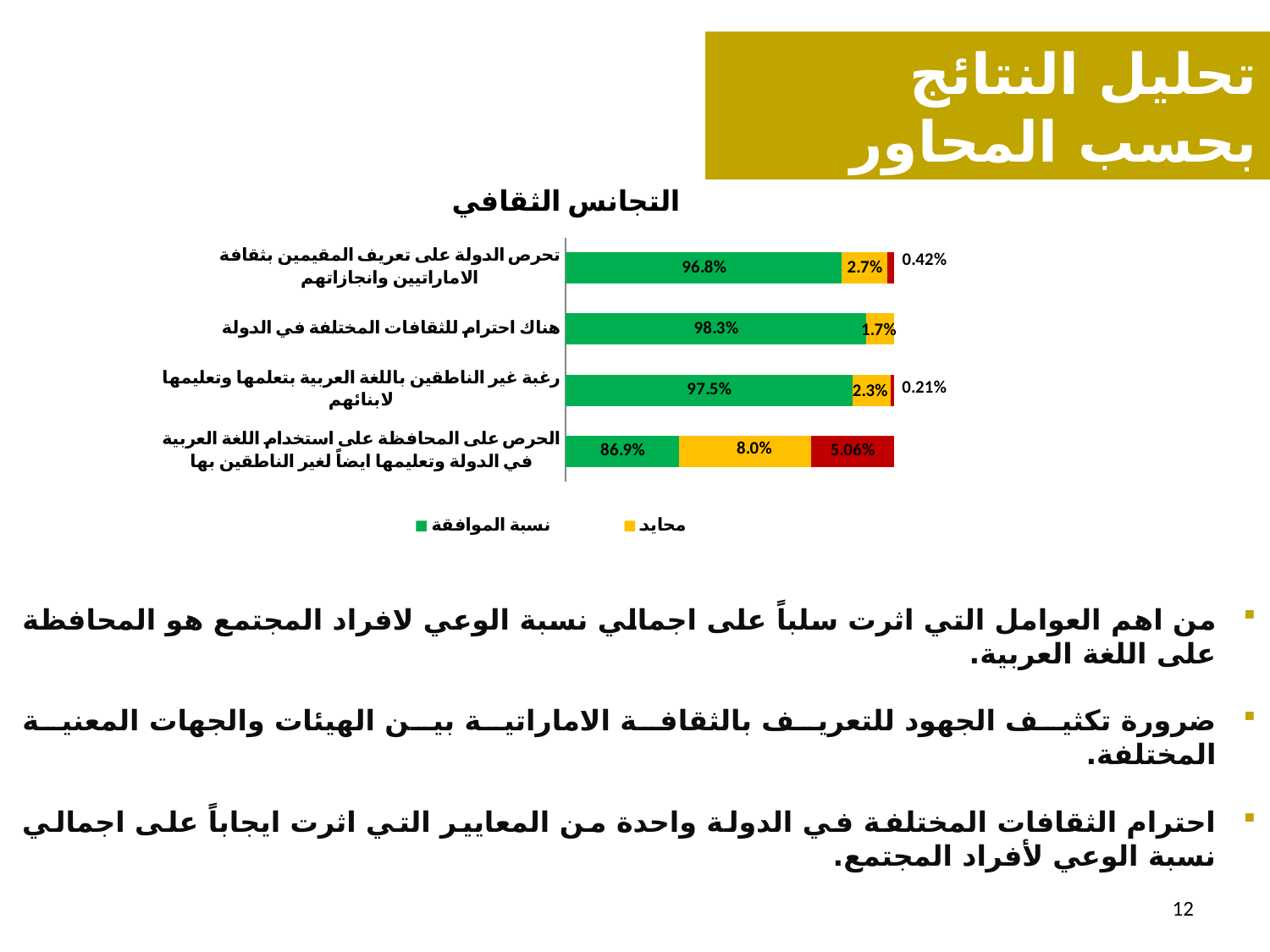
What is the difference between the نسبة الموافقة values for 'هناك احترام للثقافات المختلفة في الدولة' and 'الحرص على المحافظة على استخدام اللغة العربية في الدولة وتعليمها ايضاً لغير الناطقين بها'? 11.4% How many series does the legend list? 2 What is the نسبة الموافقة value for 'هناك احترام للثقافات المختلفة في الدولة'? 98.3% What type of chart is shown on the slide? Stacked horizontal bar chart Which is larger: the محايد value for 'تحرص الدولة على تعريف المقيمين بثقافة الاماراتيين وانجازاتهم' or for 'رغبة غير الناطقين باللغة العربية بتعلمها وتعليمها لابنائهم'? تحرص الدولة على تعريف المقيمين بثقافة الاماراتيين وانجازاتهم How many categories are plotted in the chart? 4 Which category has the lowest نسبة الموافقة value? الحرص على المحافظة على استخدام اللغة العربية في الدولة وتعليمها ايضاً لغير الناطقين بها What is the value of the red segment for 'تحرص الدولة على تعريف المقيمين بثقافة الاماراتيين وانجازاتهم'? 0.42% Which category has the highest نسبة الموافقة value? هناك احترام للثقافات المختلفة في الدولة Which colour represents نسبة الموافقة in the chart? Green What is the title of the chart? التجانس الثقافي What is the محايد value for 'الحرص على المحافظة على استخدام اللغة العربية في الدولة وتعليمها ايضاً لغير الناطقين بها'? 8.0%